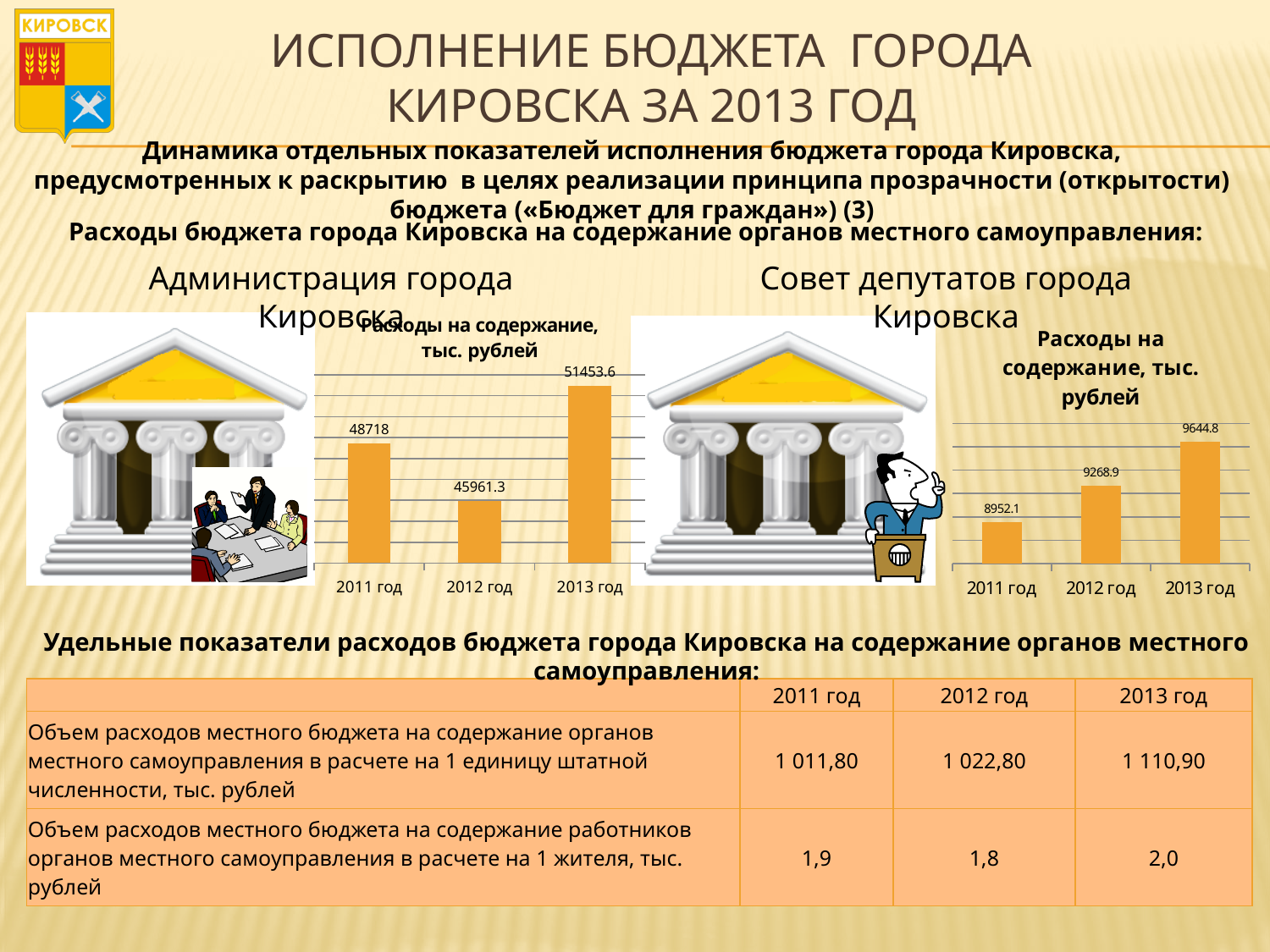
In the right chart (Совет депутатов города Кировска), what is the value for 2011 год? 8952.1 In the right chart (Совет депутатов города Кировска), what is the value for 2013 год? 9644.8 How many years are shown in the left chart (Администрация города Кировска)? 3 In the left chart (Администрация города Кировска), what is the value for 2013 год? 51453.6 In the left chart (Администрация города Кировска), what is the value for 2012 год? 45961.3 In the right chart (Совет депутатов города Кировска), which is larger: the value for 2012 год or 2013 год? 2013 год What type of chart is used for the right chart (Совет депутатов города Кировска)? bar chart In the right chart (Совет депутатов города Кировска), what is the difference between the 2012 год and 2011 год values? 316.8 In the right chart (Совет депутатов города Кировска), do the values rise or fall from 2011 год to 2013 год? rise In the left chart (Администрация города Кировска), which year has the lowest value? 2012 год In the left chart (Администрация города Кировска), what is the difference between the 2013 год and 2011 год values? 2735.6 In the left chart (Администрация города Кировска), which year has the highest value? 2013 год